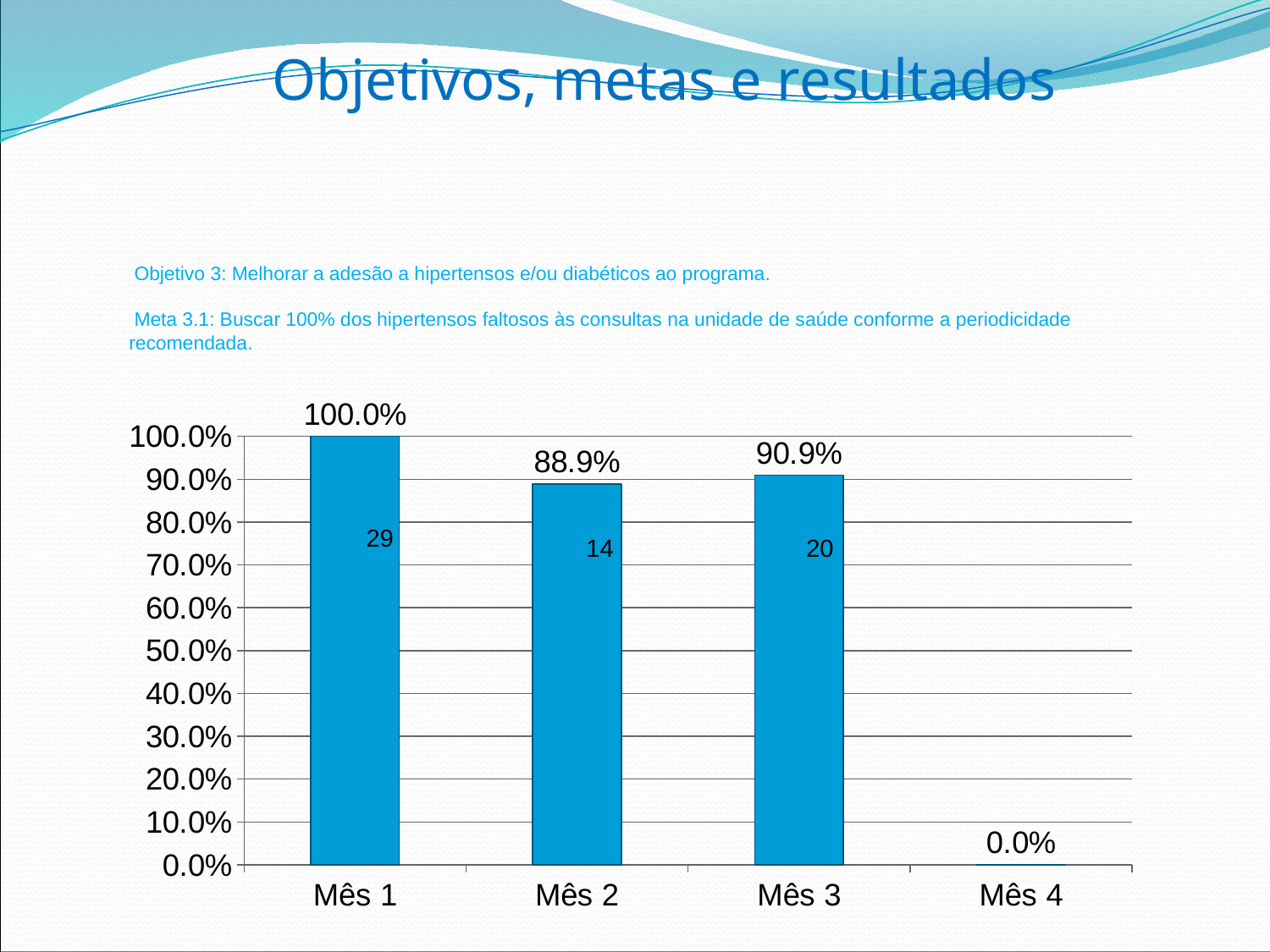
What kind of chart is shown on the slide? Bar chart How many months are shown on the x axis of the chart? 4 What is the percentage value shown for Mês 2? 88.9% What is the percentage value shown for Mês 3? 90.9% Which is larger, the percentage for Mês 2 or for Mês 3? Mês 3 What is the difference in percentage points between Mês 1 and Mês 2? 11.1 What is the percentage value shown for Mês 1? 100.0% What is the percentage value shown for Mês 4? 0.0% Which month has the lowest percentage value? Mês 4 Which month has the highest percentage value? Mês 1 What number is printed inside the bar for Mês 2? 14 What number is printed inside the bar for Mês 3? 20